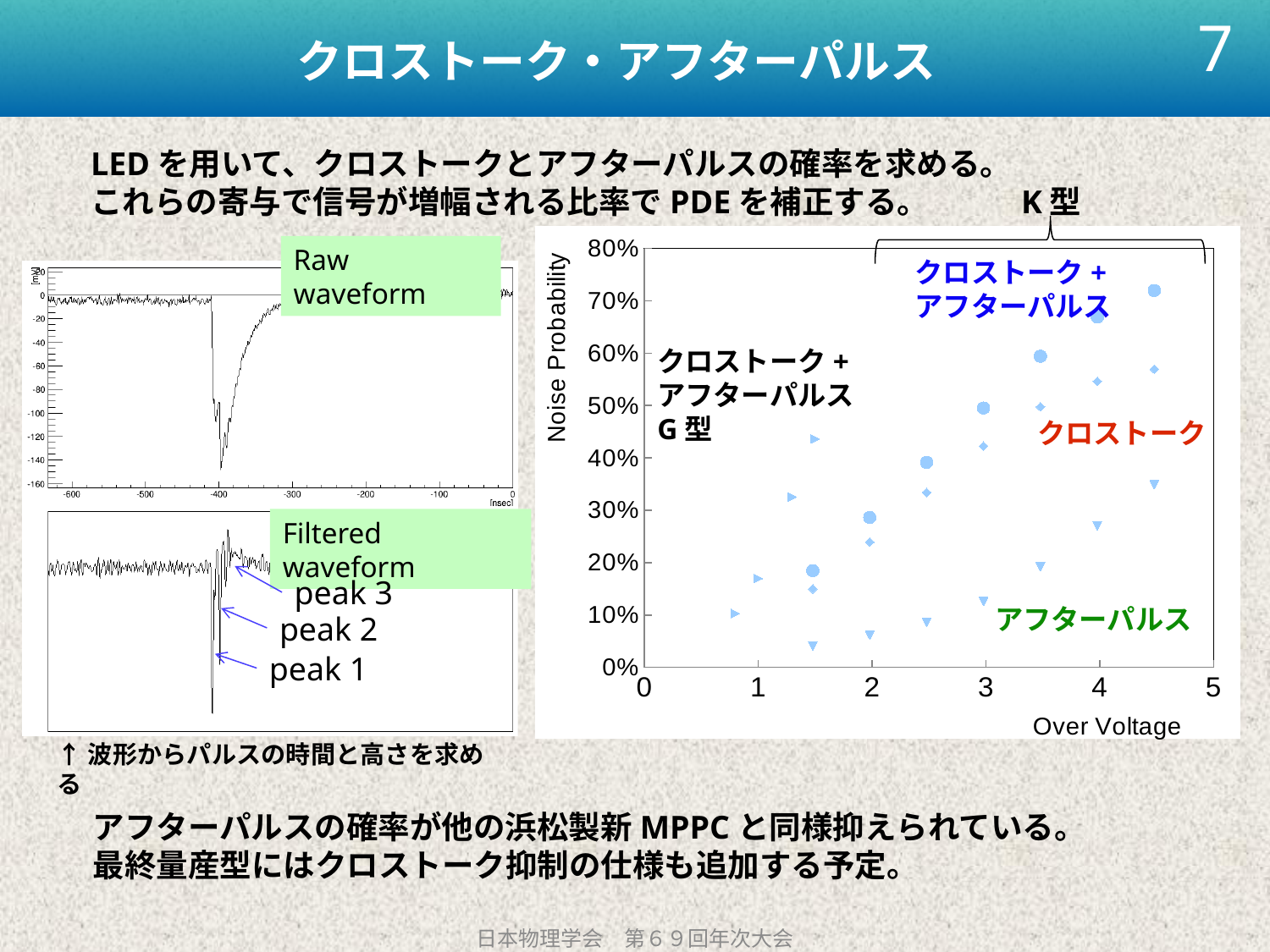
In the right-hand chart, which labeled series reaches the highest noise probability? クロストーク + アフターパルス (K型) How many labeled data series are shown in the right-hand chart? 4 In the right-hand chart, is the アフターパルス value at Over Voltage 4.5 greater or less than 30%? greater In the right-hand chart, is the クロストーク + アフターパルス (K型) value at Over Voltage 4.5 greater or less than 60%? greater In the right-hand chart, what is the label of the horizontal axis? Over Voltage In the right-hand chart, is the クロストーク + アフターパルス (K型) value at Over Voltage 2 greater or less than 20%? greater In the right-hand chart, do the noise probability values rise or fall as Over Voltage increases? rise What kind of chart is the Noise Probability vs Over Voltage plot on the right of the slide? scatter chart In the right-hand chart, what is the label of the vertical axis? Noise Probability In the right-hand chart, at Over Voltage 4, which is larger: クロストーク or アフターパルス? クロストーク